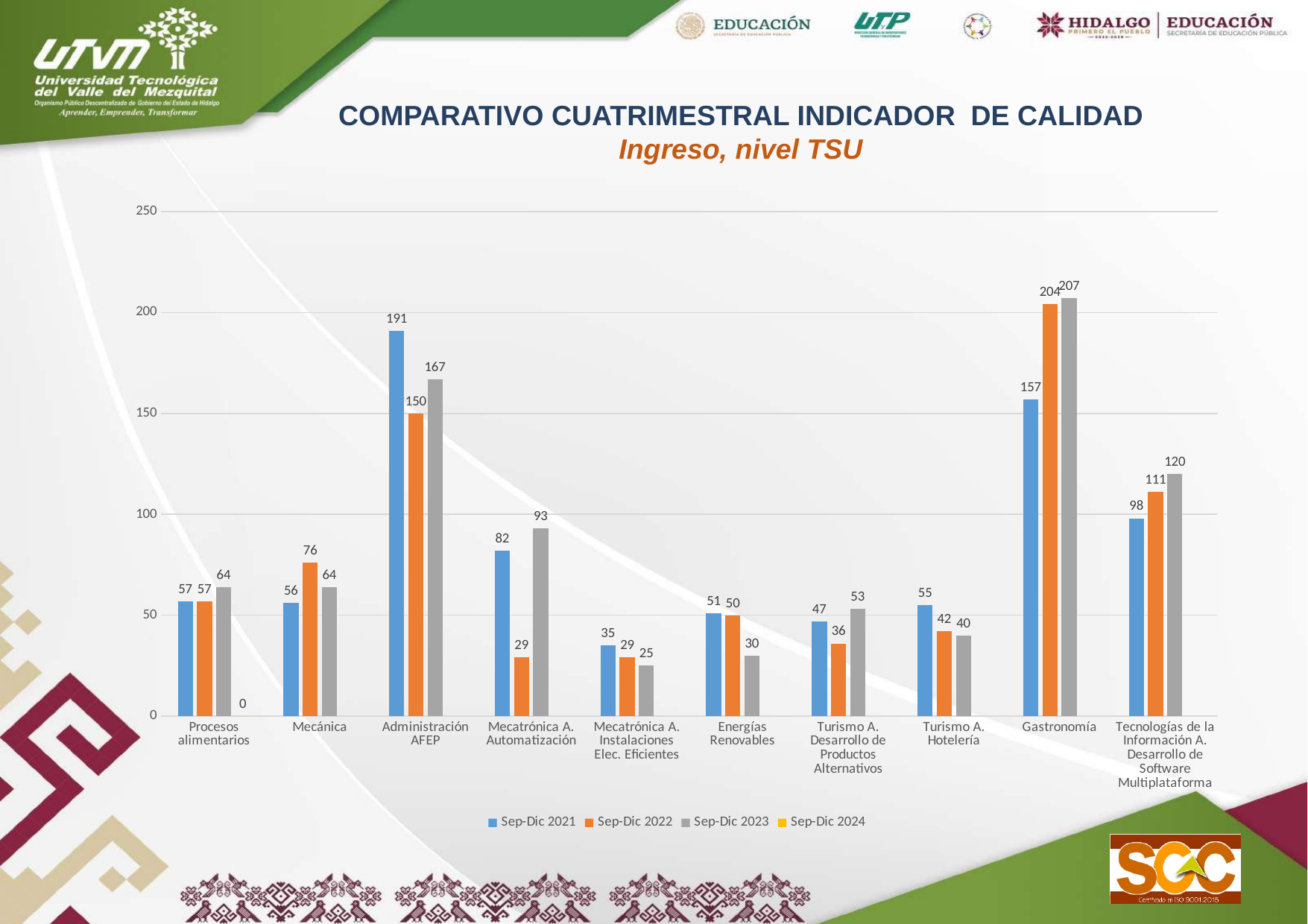
What is the subtitle of the chart shown in orange italics? Ingreso, nivel TSU What is the value for Administración AFEP in Sep-Dic 2021? 191 Which category has the highest value in Sep-Dic 2022? Gastronomía How many categories are shown on the x axis? 10 What is the value for Gastronomía in Sep-Dic 2023? 207 How many series does the legend list? 4 Which category has the lowest value in Sep-Dic 2023? Mecatrónica A. Instalaciones Elec. Eficientes What is the difference between the Sep-Dic 2023 and Sep-Dic 2021 values for Tecnologías de la Información A. Desarrollo de Software Multiplataforma? 22 Which is larger for Mecánica: the Sep-Dic 2022 value or the Sep-Dic 2023 value? Sep-Dic 2022 What is the value for Mecatrónica A. Automatización in Sep-Dic 2022? 29 Do the values for Mecatrónica A. Instalaciones Elec. Eficientes rise or fall from Sep-Dic 2021 to Sep-Dic 2023? fall What kind of chart is shown on the slide? bar chart